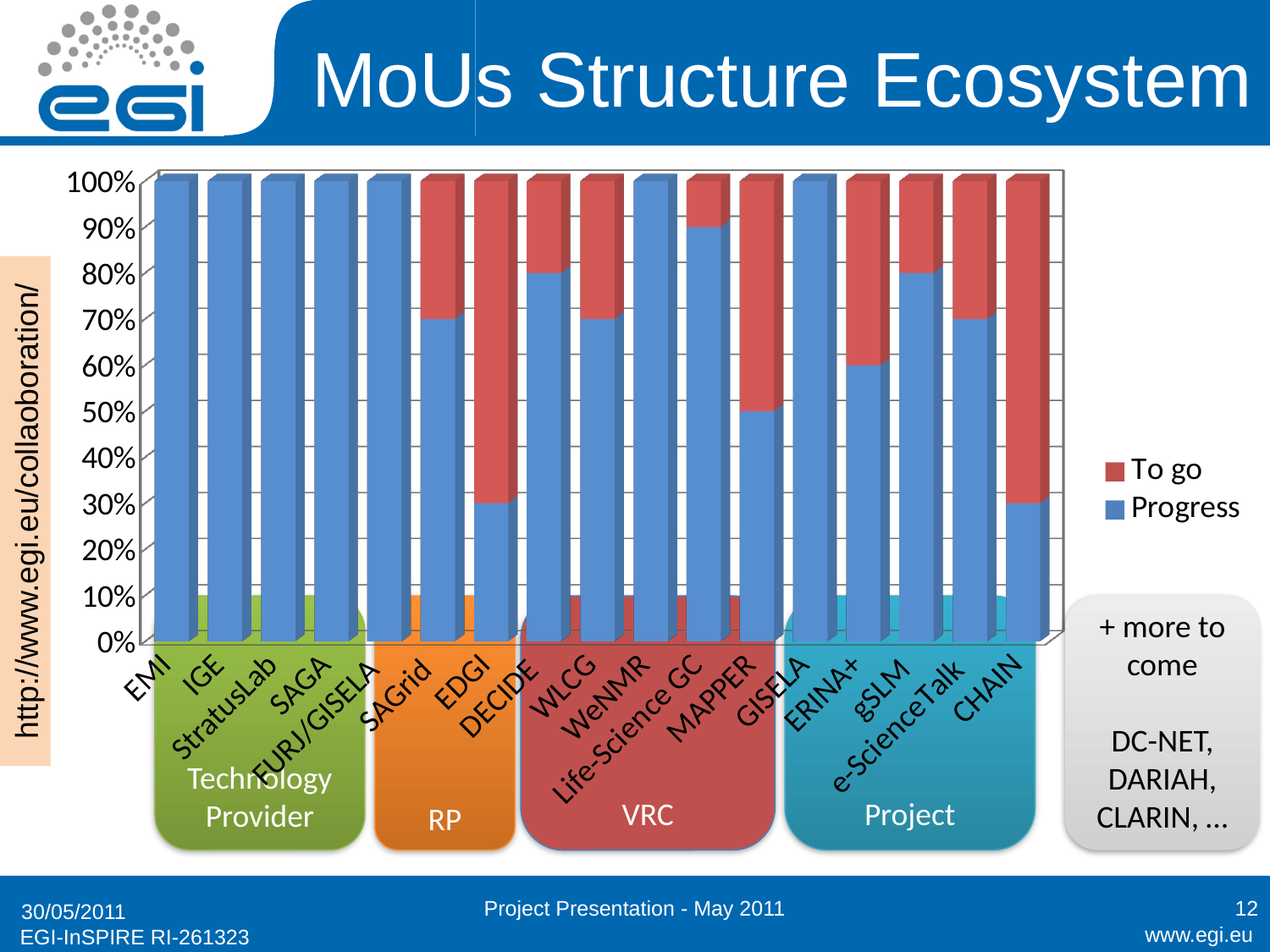
Is the Progress value for DECIDE greater or less than 40%? greater Which has a larger Progress value, MAPPER or Life-Science GC? Life-Science GC Which has a larger Progress value, DECIDE or WLCG? DECIDE What kind of chart is shown on the slide? Stacked bar chart What is the title of the slide containing the chart? MoUs Structure Ecosystem Is the Progress value for gSLM greater or less than 70%? greater How many MoU categories (bars) are plotted along the x axis? 17 What are the two series named in the legend? To go and Progress Is the Progress value for ERINA+ greater or less than 70%? less How many series does the legend list? 2